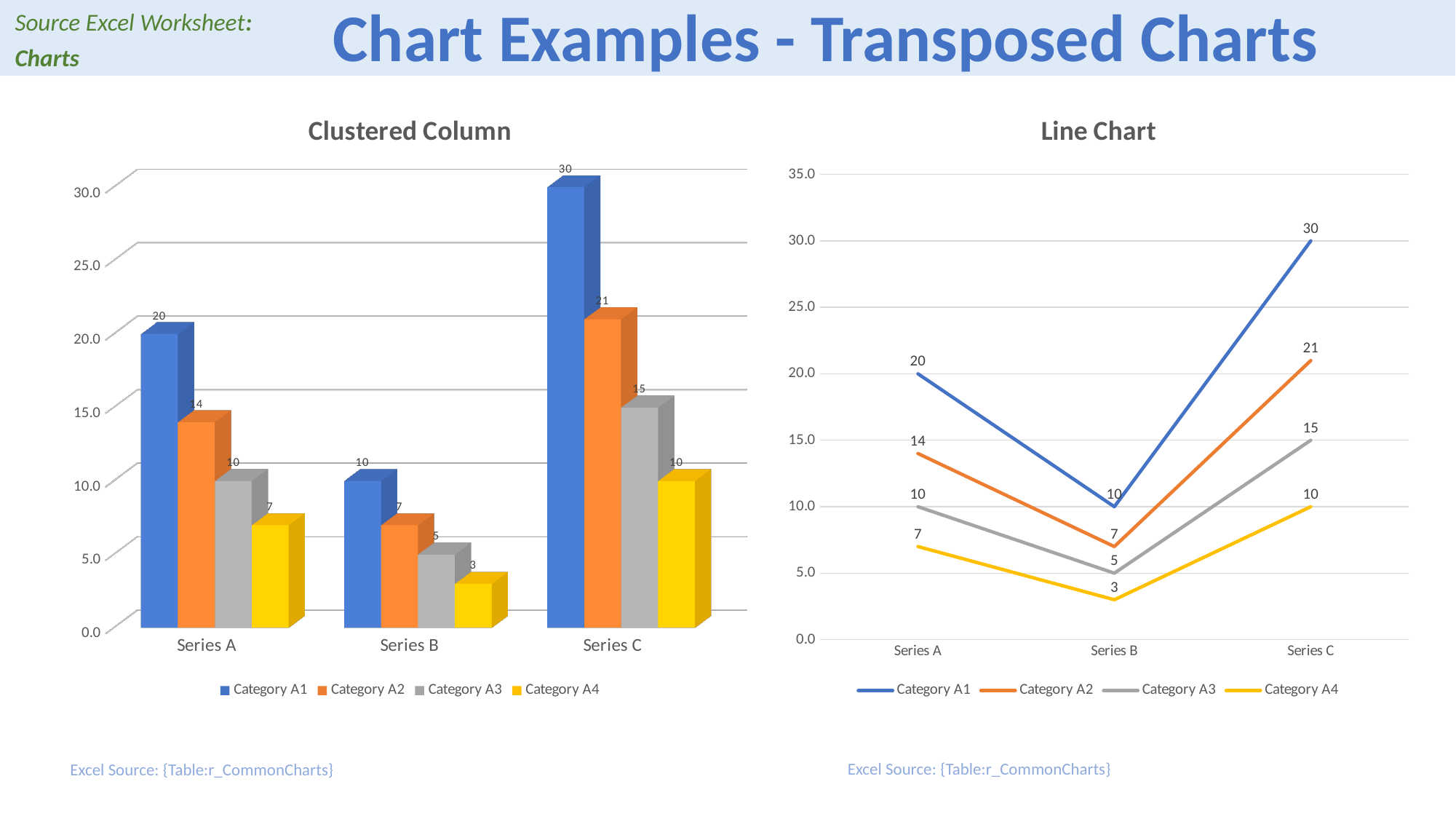
In the Line Chart, does the Category A4 line rise or fall from Series A to Series B? Fall In the Clustered Column chart, what is the value for Category A4 in Series B? 3 In the Line Chart, what is the difference between Category A1 and Category A2 at Series C? 9 What kind of chart is the chart on the left of the slide? Bar chart How many series does the legend of the Line Chart list? 4 In the Clustered Column chart, what is the value for Category A1 in Series C? 30 What is the title of the chart on the right of the slide? Line Chart In the Clustered Column chart, which series has the lowest value for Category A3? Series B In the Clustered Column chart, which is larger: Category A2 in Series A or Category A3 in Series C? Category A3 in Series C In the Line Chart, which series point has the highest value for Category A1? Series C In the Line Chart, what is the value for Category A2 at Series A? 14 How many categories are shown on the x axis of the Clustered Column chart? 3